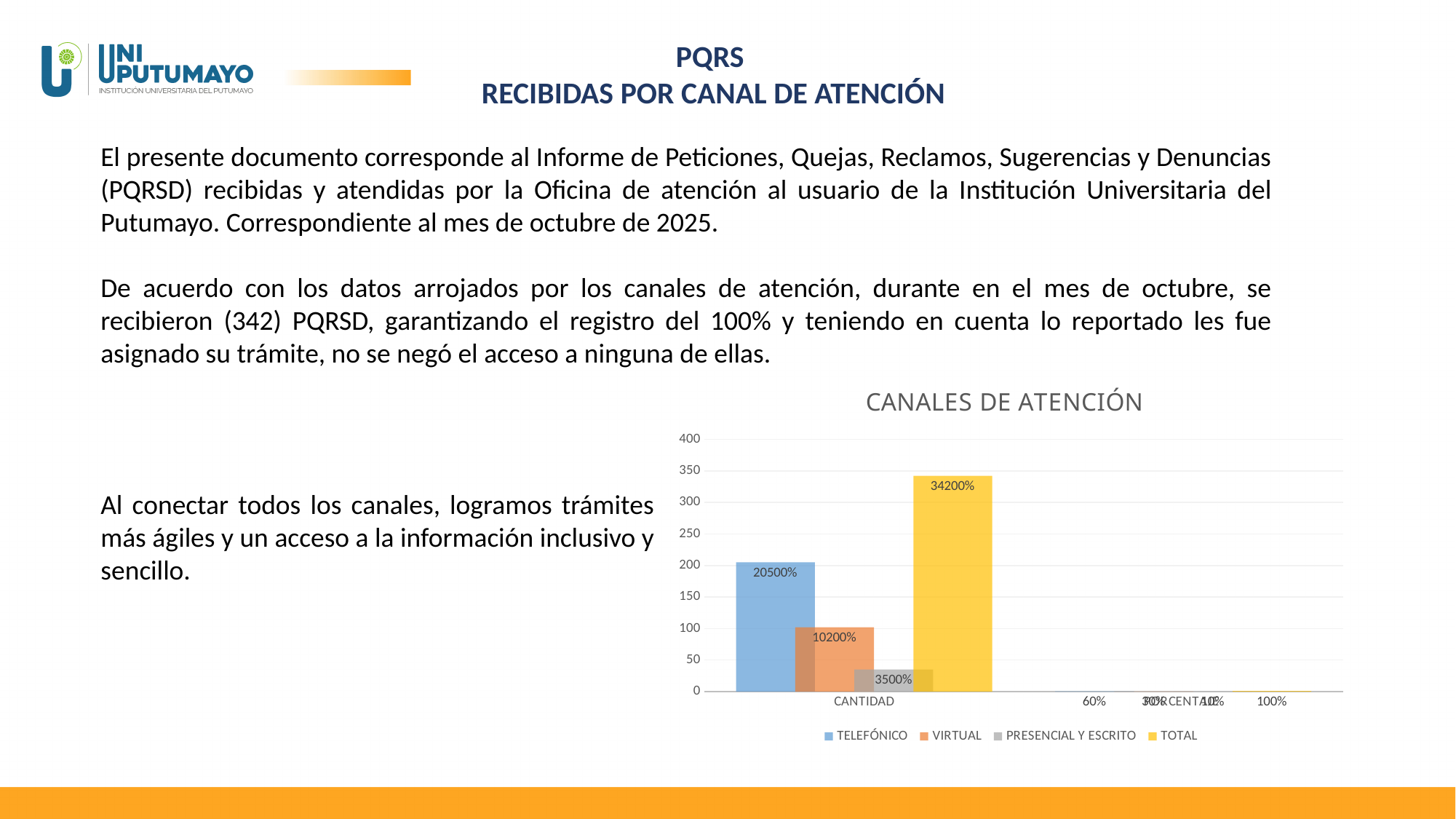
What type of chart is shown under the title CANALES DE ATENCIÓN? bar chart What is the data label on the TOTAL bar for CANTIDAD? 34200% How many series does the chart legend list? 4 Is the TELEFÓNICO bar for CANTIDAD greater or less than 150 on the vertical axis? greater What is the data label on the TELEFÓNICO bar for CANTIDAD? 20500% Which series has the shortest bar in the CANTIDAD group? PRESENCIAL Y ESCRITO In the CANTIDAD group, which bar is taller, TELEFÓNICO or VIRTUAL? TELEFÓNICO What is the data label on the VIRTUAL bar for CANTIDAD? 10200% Which series has the tallest bar in the CANTIDAD group? TOTAL What is the data label on the PRESENCIAL Y ESCRITO bar for CANTIDAD? 3500% Which legend entry is shown in yellow? TOTAL What is the title of the chart on the slide? CANALES DE ATENCIÓN